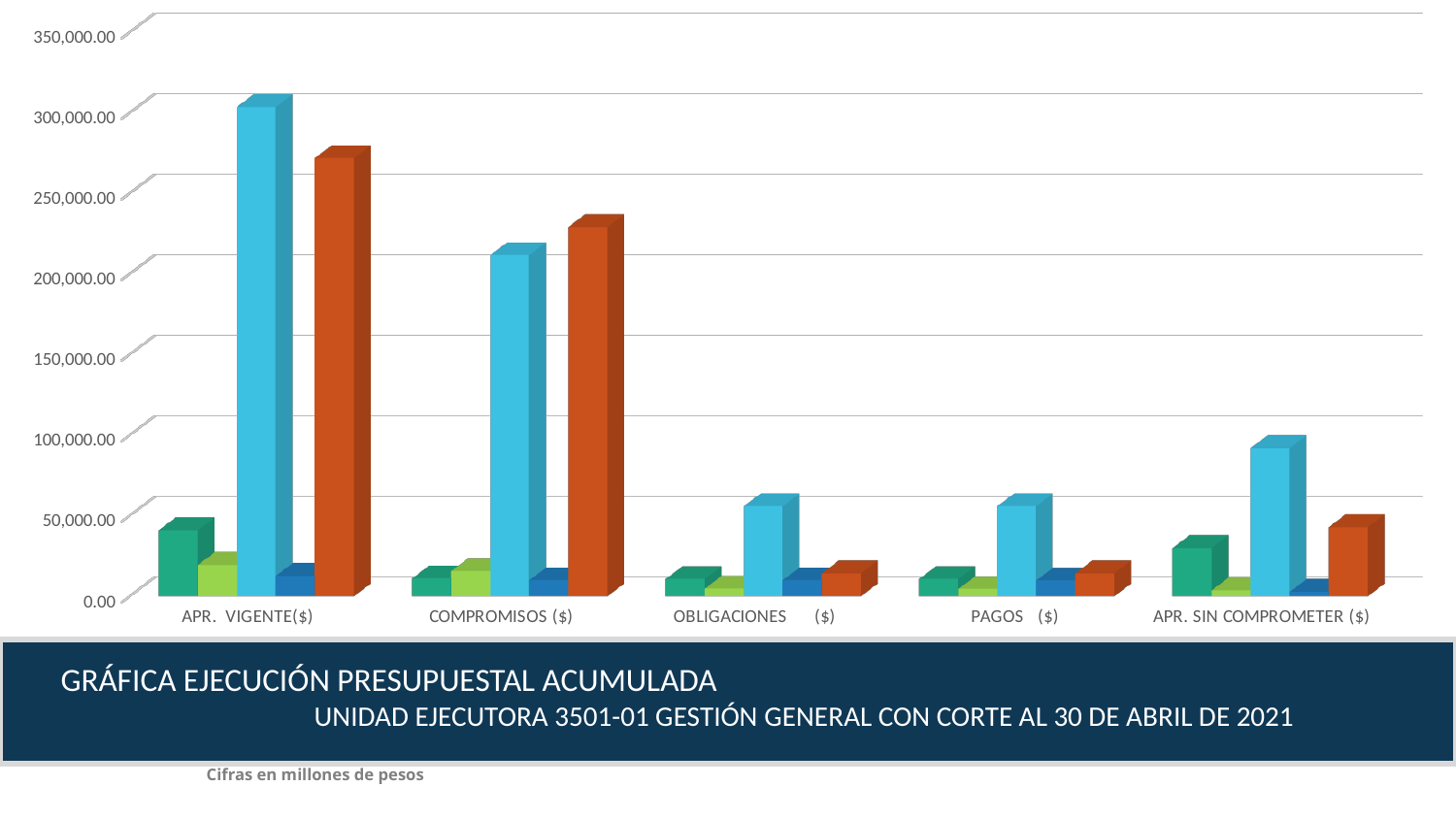
Is the value of the orange bar for COMPROMISOS ($) greater or less than 200,000.00? greater How many categories are shown along the x axis of the chart? 5 For APR. VIGENTE($), which bar is taller, the light blue bar or the orange bar? the light blue bar Is the value of the orange bar for APR. SIN COMPROMETER ($) greater or less than 50,000.00? less What kind of chart is shown on the slide? bar chart What is the highest value shown on the vertical axis of the chart? 350,000.00 In which category is the dark green bar the tallest? APR. VIGENTE($) Is the value of the light blue bar for APR. SIN COMPROMETER ($) greater or less than 100,000.00? less For COMPROMISOS ($), which bar is taller, the light blue bar or the orange bar? the orange bar In which category is the light blue bar the tallest? APR. VIGENTE($)